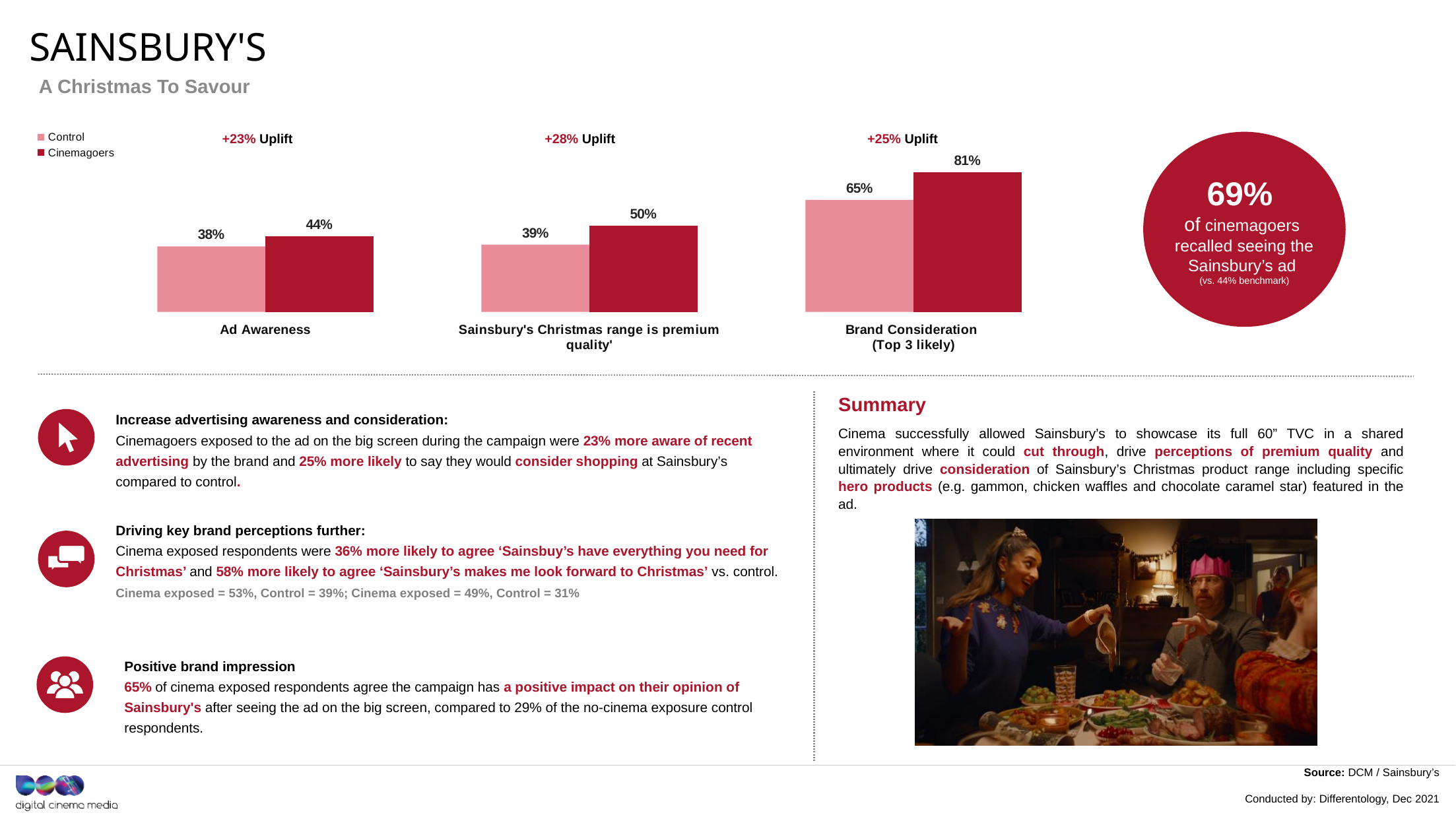
What kind of chart is the Brand Consideration (Top 3 likely) chart? Bar chart What uplift is shown above the 'Sainsbury's Christmas range is premium quality' chart? +28% Uplift In the Ad Awareness chart, which series has the larger value, Control or Cinemagoers? Cinemagoers In the 'Sainsbury's Christmas range is premium quality' chart, what is the value for Cinemagoers? 50% In the Ad Awareness chart, what is the value for Cinemagoers? 44% In the Brand Consideration (Top 3 likely) chart, what is the value for Control? 65% In the 'Sainsbury's Christmas range is premium quality' chart, what is the difference between the Cinemagoers and Control values? 11% In the Ad Awareness chart, what is the value for Control? 38% In the 'Sainsbury's Christmas range is premium quality' chart, what is the value for Control? 39% In the Brand Consideration (Top 3 likely) chart, what is the value for Cinemagoers? 81% In the Brand Consideration (Top 3 likely) chart, what is the difference between the Cinemagoers and Control values? 16% How many series does the legend list for the bar charts? 2